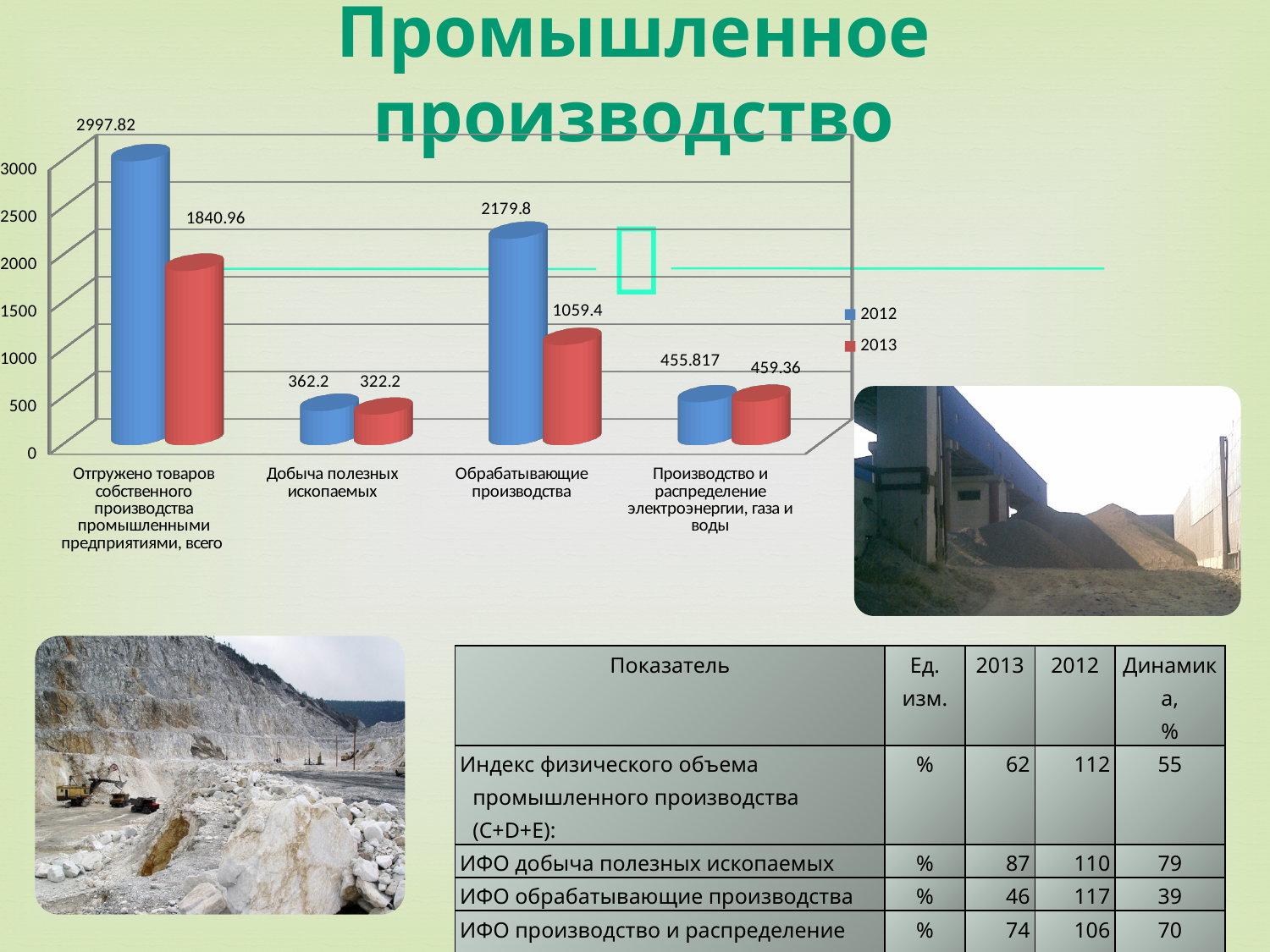
Which category has the lowest 2013 value? Добыча полезных ископаемых What is the 2013 value for Производство и распределение электроэнергии, газа и воды? 459.36 What is the 2012 value for Добыча полезных ископаемых? 362.2 What is the difference between the 2012 and 2013 values for Обрабатывающие производства? 1120.4 How many series does the chart legend list? 2 What is the difference between the 2012 and 2013 values for Добыча полезных ископаемых? 40 What is the 2012 value for Отгружено товаров собственного производства промышленными предприятиями, всего? 2997.82 How many categories are shown on the x axis of the chart? 4 Which category has the highest 2012 value? Отгружено товаров собственного производства промышленными предприятиями, всего Which is larger for Обрабатывающие производства: the 2012 value or the 2013 value? 2012 What is the 2013 value for Обрабатывающие производства? 1059.4 What kind of chart is shown on the slide? Bar chart